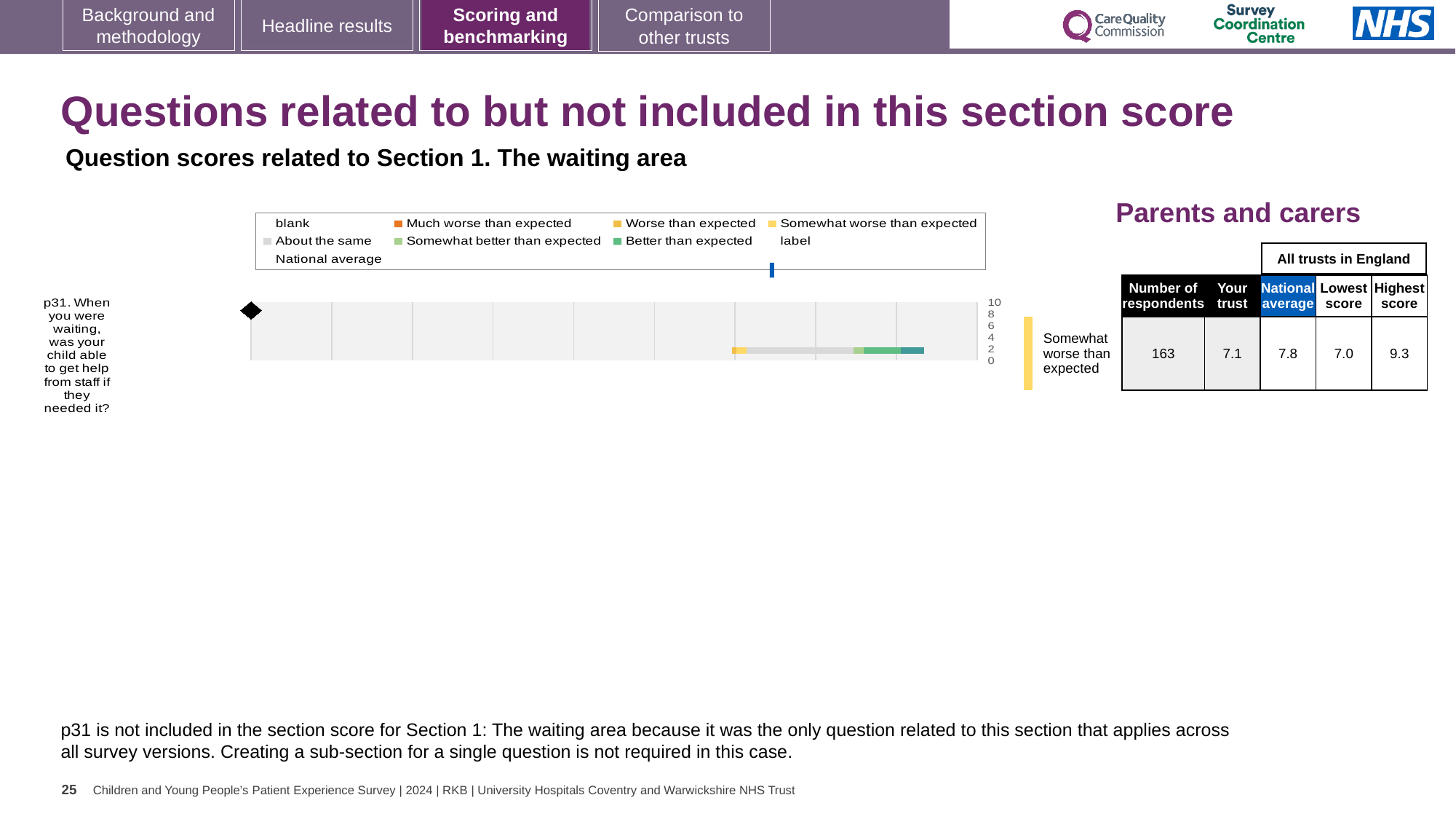
What is the national average score for p31 in the table next to the chart? 7.8 Is the trust score for p31 greater or less than 8 on the chart's axis? less Which question is plotted in the chart? p31. When you were waiting, was your child able to get help from staff if they needed it? Which is larger for p31, the trust score or the national average? national average What is the lowest score among all trusts in England for p31? 7.0 What kind of chart is shown for question p31? bar chart What is the difference between the national average and the trust score for p31? 0.7 What is the highest score among all trusts in England for p31? 9.3 How many respondents answered p31? 163 How many questions (categories) are plotted in the chart? 1 What is the 'Your trust' score for p31 in the table next to the chart? 7.1 What rating label is shown beside the chart for p31? Somewhat worse than expected